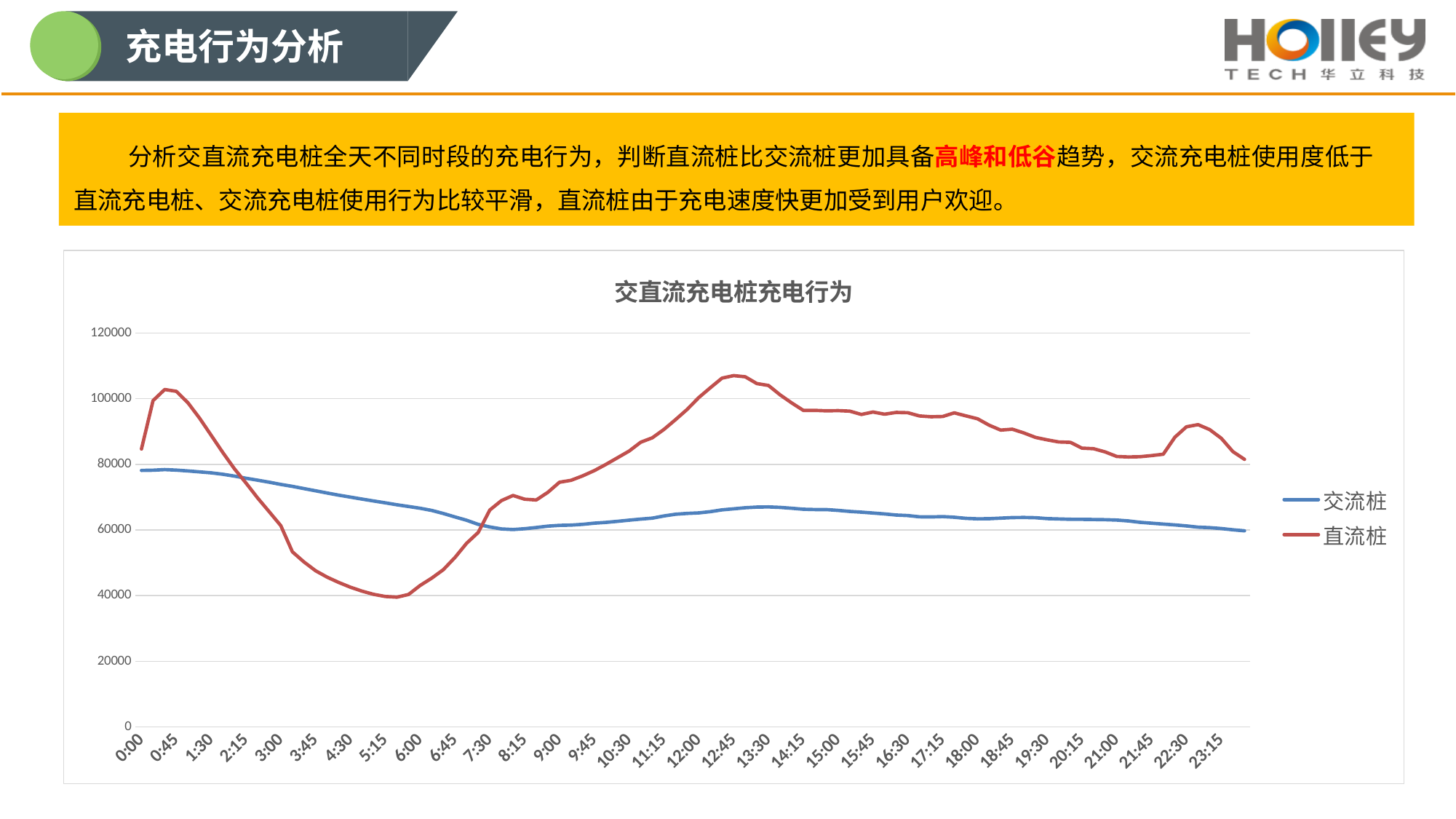
Which series drops to the lowest value anywhere on the chart? 直流桩 Is the value for 直流桩 at 12:45 greater or less than 100000? greater At 12:45, which series has the larger value, 交流桩 or 直流桩? 直流桩 What kind of chart is shown on the slide? line chart Which series reaches the highest value anywhere on the chart? 直流桩 What is the title of the chart? 交直流充电桩充电行为 How many series does the legend of the chart list? 2 What colour is the line for 直流桩? red At 4:30, which series has the larger value, 交流桩 or 直流桩? 交流桩 Is the value for 直流桩 at 5:15 greater or less than 60000? less How many time labels are shown along the x axis of the chart? 32 Does the 直流桩 line rise or fall between 0:45 and 5:15? fall